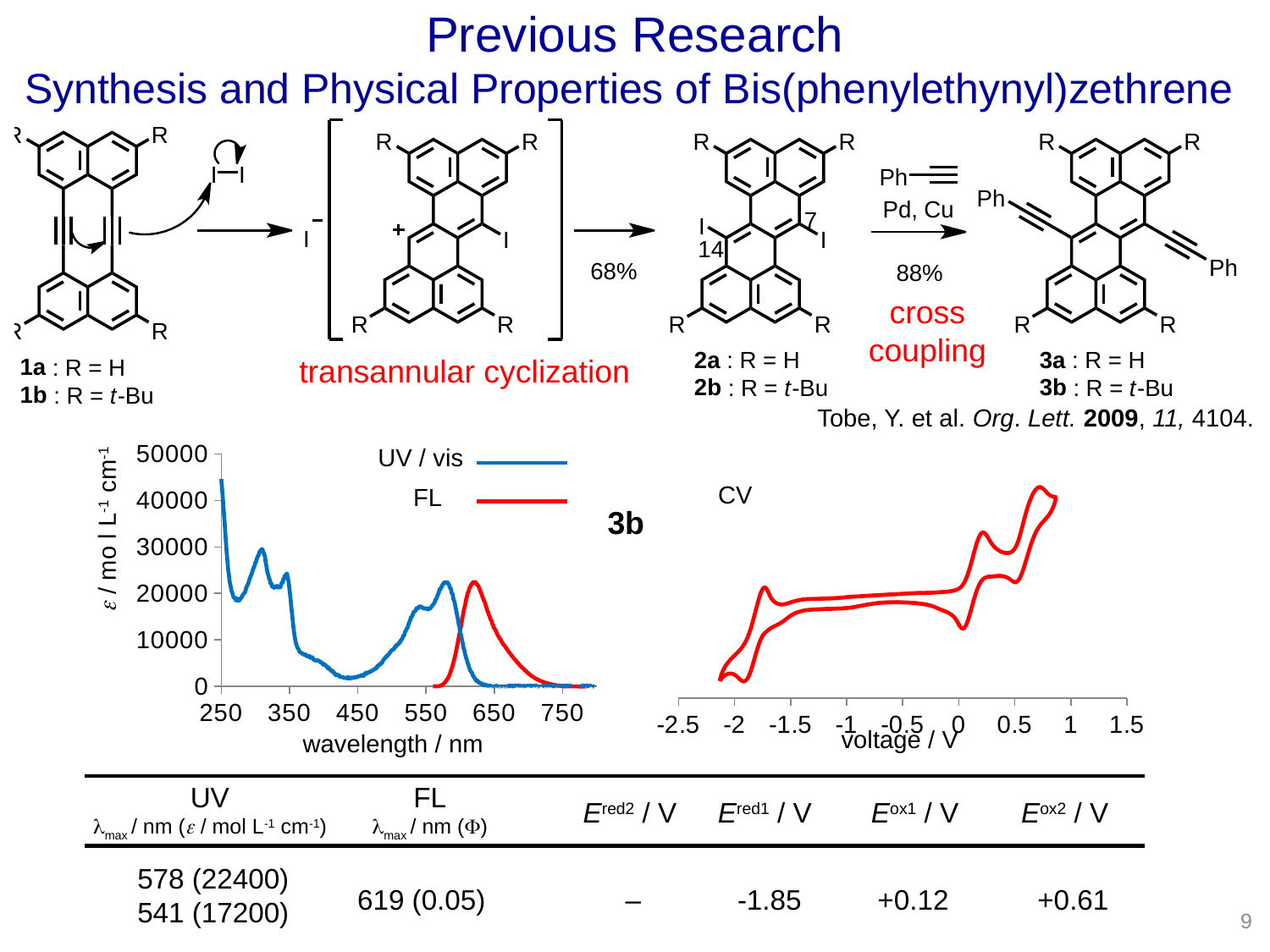
In the left spectrum chart, is the FL peak value greater or less than 30000? less In the left spectrum chart, which colour is the FL series drawn in? red In the left spectrum chart, is the UV/vis value at 250 nm greater or less than 40000? greater How many series does the legend of the left spectrum chart list? 2 What is the x-axis label of the left spectrum chart? wavelength / nm According to the table below the CV chart, what is E ox1 / V for 3b? +0.12 In the left spectrum chart, is the UV/vis value at 450 nm greater or less than 10000? less According to the table, what is the FL λmax of 3b in nm? 619 What is the x-axis label of the CV chart on the right? voltage / V How many tick labels are shown on the x axis of the CV chart? 9 What kind of chart is the UV/vis and FL spectrum on the left of the slide? line chart According to the table, at what wavelength (nm) is the UV λmax of 3b with ε = 22400? 578